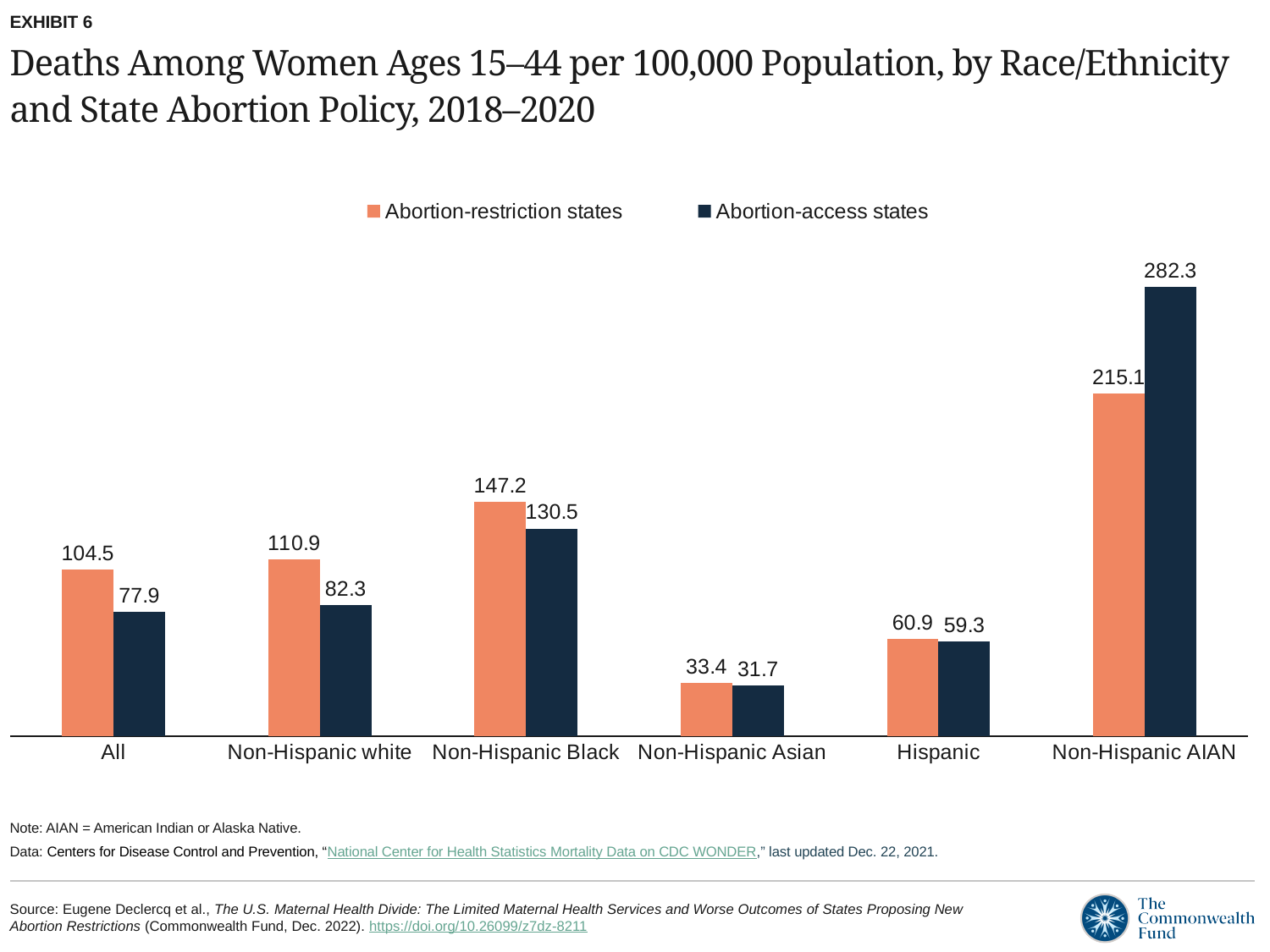
What is the value for All in abortion-access states? 77.9 Which category has the lowest value for abortion-restriction states? Non-Hispanic Asian What is the value for Hispanic in abortion-access states? 59.3 What is the value for Non-Hispanic Black in abortion-restriction states? 147.2 What is the difference between the abortion-restriction and abortion-access values for Non-Hispanic white? 28.6 What is the difference between the abortion-access and abortion-restriction values for Non-Hispanic AIAN? 67.2 How many race/ethnicity categories are shown on the x axis? 6 What kind of chart is shown on the slide? Bar chart Which is larger for Non-Hispanic Black: the abortion-restriction states value or the abortion-access states value? Abortion-restriction states How many series does the legend list? 2 Which colour represents abortion-access states in the chart? Dark navy blue Which category has the highest value for abortion-access states? Non-Hispanic AIAN